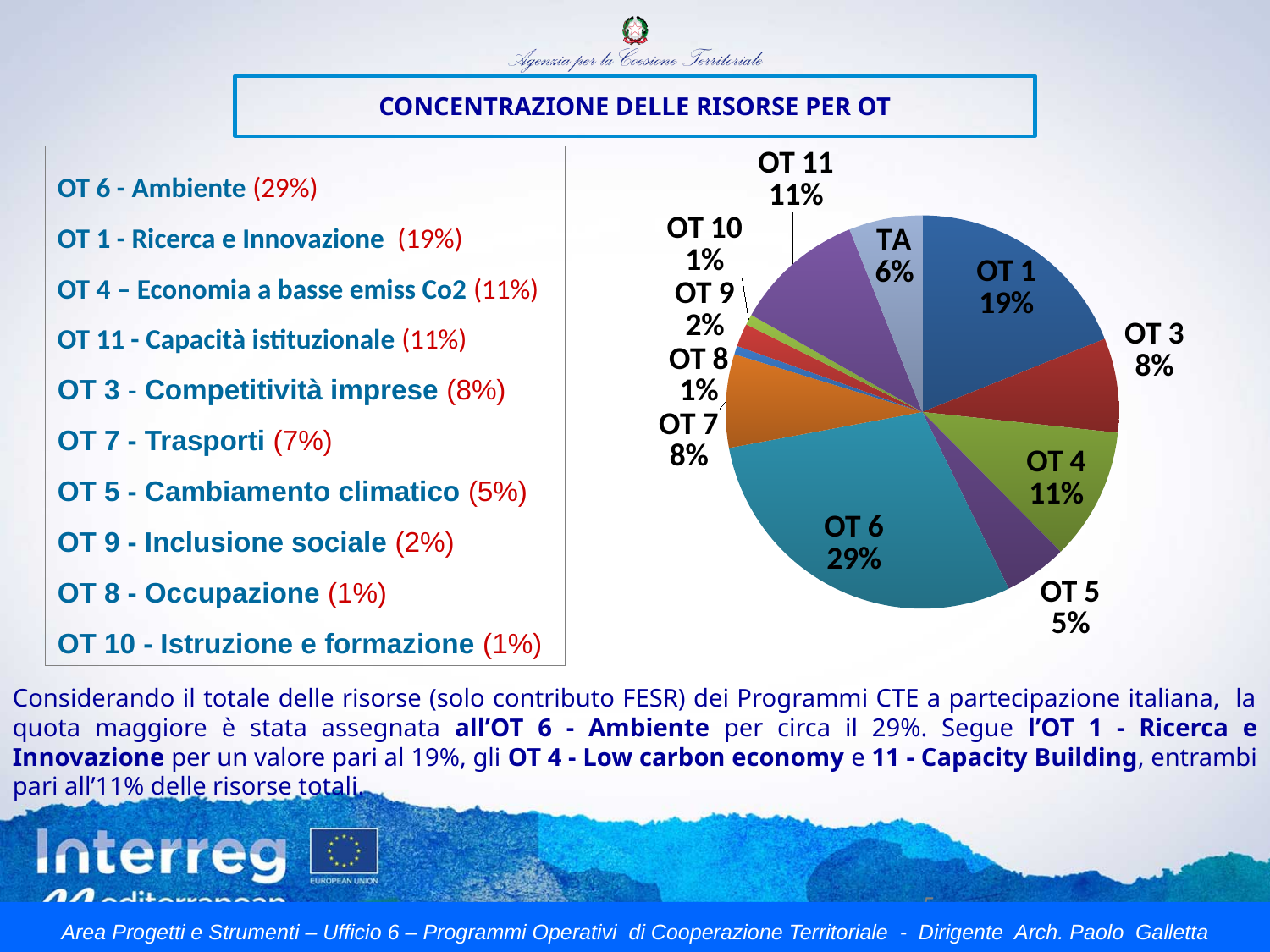
What is the difference in percentage points between OT 6 and OT 1? 10 What share of the pie does OT 6 represent? 29% What percentage is shown for OT 1 in the pie chart? 19% Which is larger in the pie chart, OT 4 or OT 3? OT 4 How many slices does the pie chart have? 11 Which slice of the pie chart is the largest? OT 6 What percentage is shown for OT 11 in the pie chart? 11% What is the title of the chart? CONCENTRAZIONE DELLE RISORSE PER OT What is the combined share of OT 8 and OT 10 in the pie chart? 2% What type of chart is shown on the slide? pie chart What percentage is shown for TA in the pie chart? 6% What percentage is shown for OT 5 in the pie chart? 5%